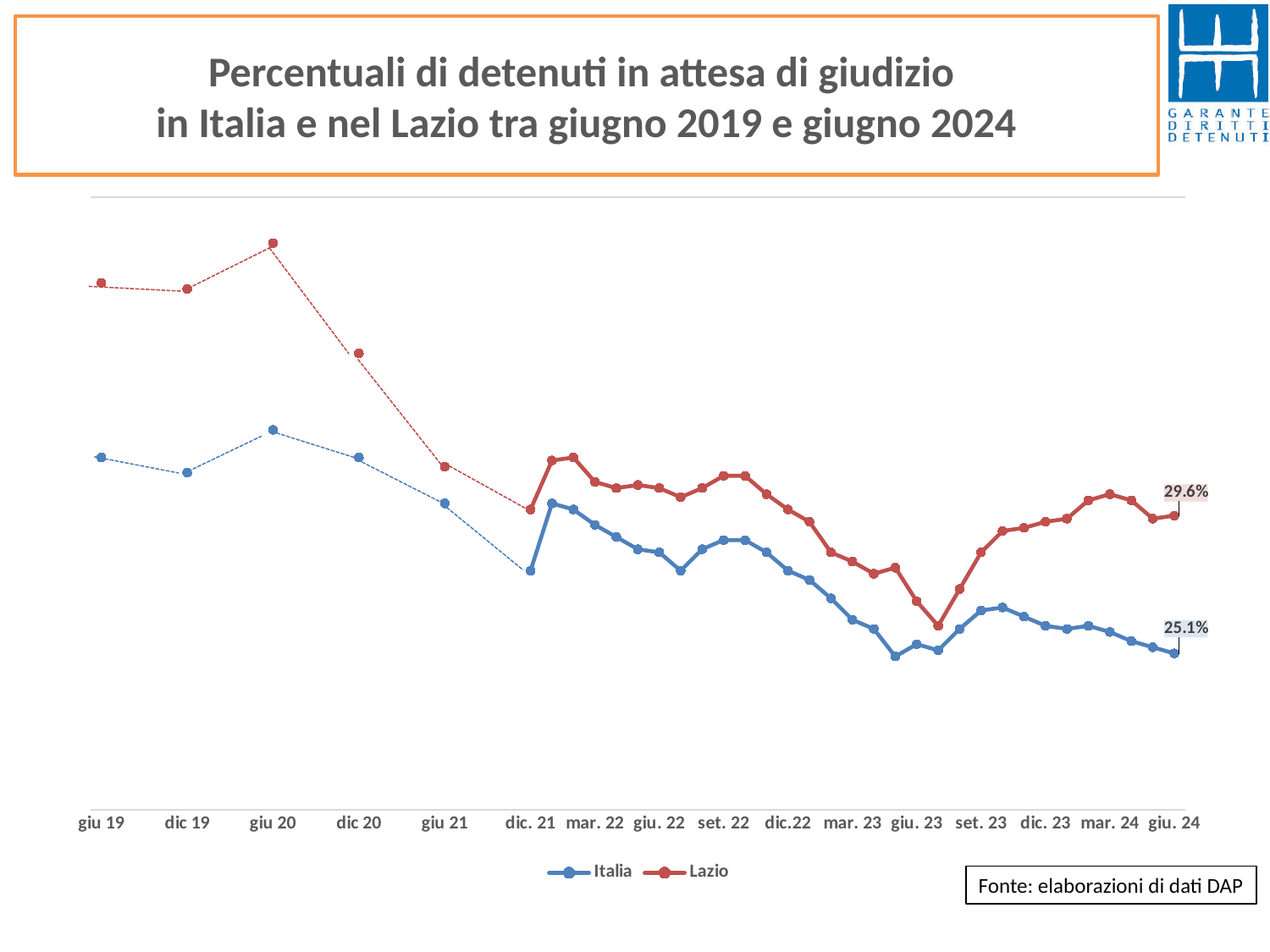
What is the value for Lazio at giu. 24? 29.6% What is the value for Italia at giu. 24? 25.1% At which x-axis label does the Lazio series reach its highest point? giu 20 What kind of chart is shown on the slide? line chart How many labels are shown on the x axis? 16 How many series does the legend list? 2 At which x-axis label does the Italia series reach its highest point? giu 20 Which series is higher than the other across the whole period shown? Lazio Which colour is used for the Italia series? blue Overall, do the values rise or fall from giu 19 to giu. 24? fall At giu. 24, which series has the larger value, Italia or Lazio? Lazio What is the difference between the Lazio and Italia values at giu. 24? 4.5 percentage points